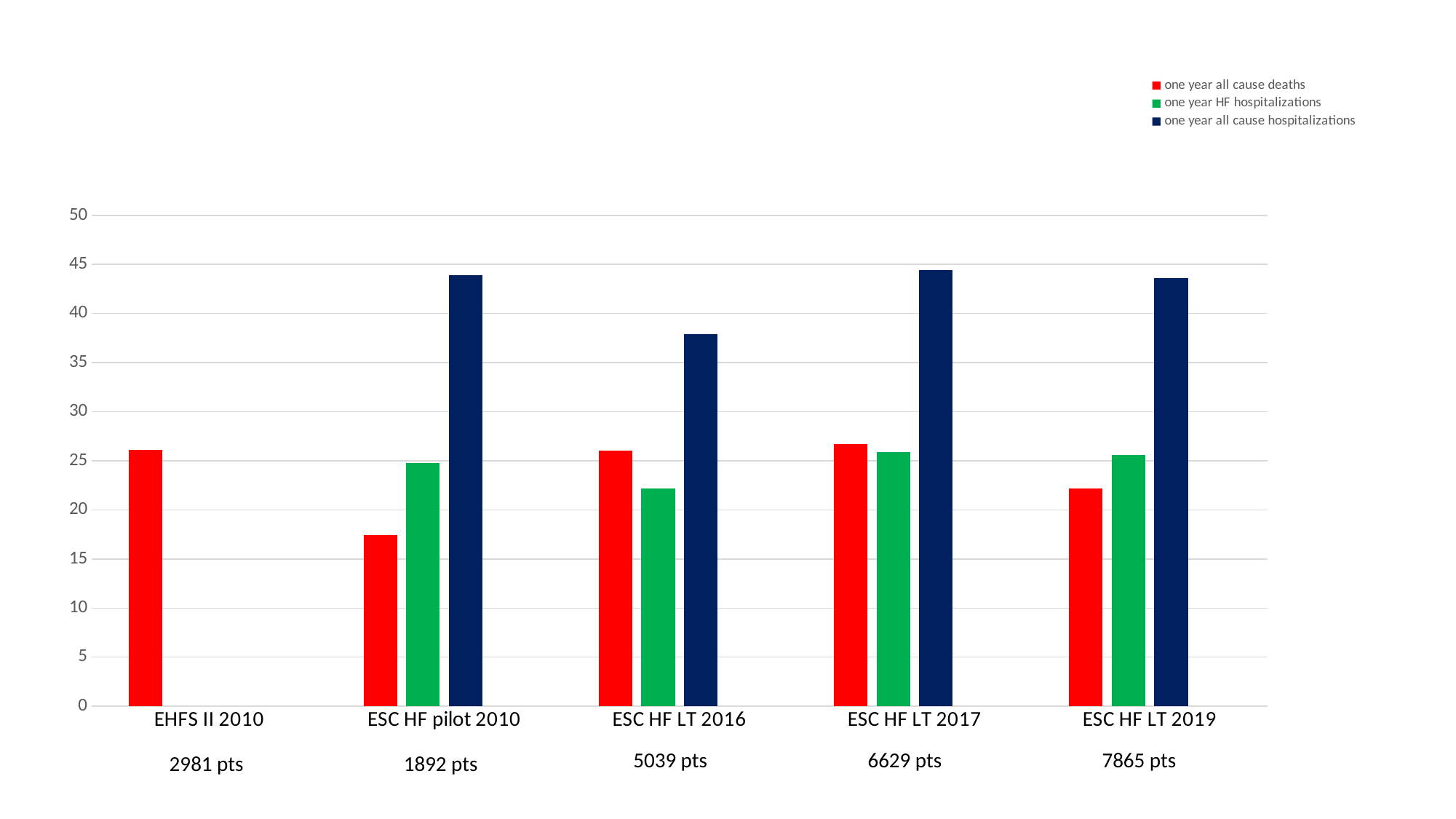
In ESC HF LT 2016, which is larger: one year all cause deaths or one year HF hospitalizations? one year all cause deaths Is the value for one year all cause hospitalizations in ESC HF pilot 2010 greater or less than 40? greater How many study categories are shown on the x axis? 5 Which study has the lowest value for one year all cause deaths? ESC HF pilot 2010 In ESC HF pilot 2010, which is larger: one year all cause deaths or one year HF hospitalizations? one year HF hospitalizations Which colour represents one year all cause deaths in the legend? red Which study has the lowest value for one year HF hospitalizations? ESC HF LT 2016 Is the value for one year all cause hospitalizations in ESC HF LT 2016 greater or less than 40? less What kind of chart is shown on the slide? bar chart How many series does the legend list? 3 Which study has the lowest value for one year all cause hospitalizations? ESC HF LT 2016 Is the value for one year all cause deaths in ESC HF pilot 2010 greater or less than 20? less